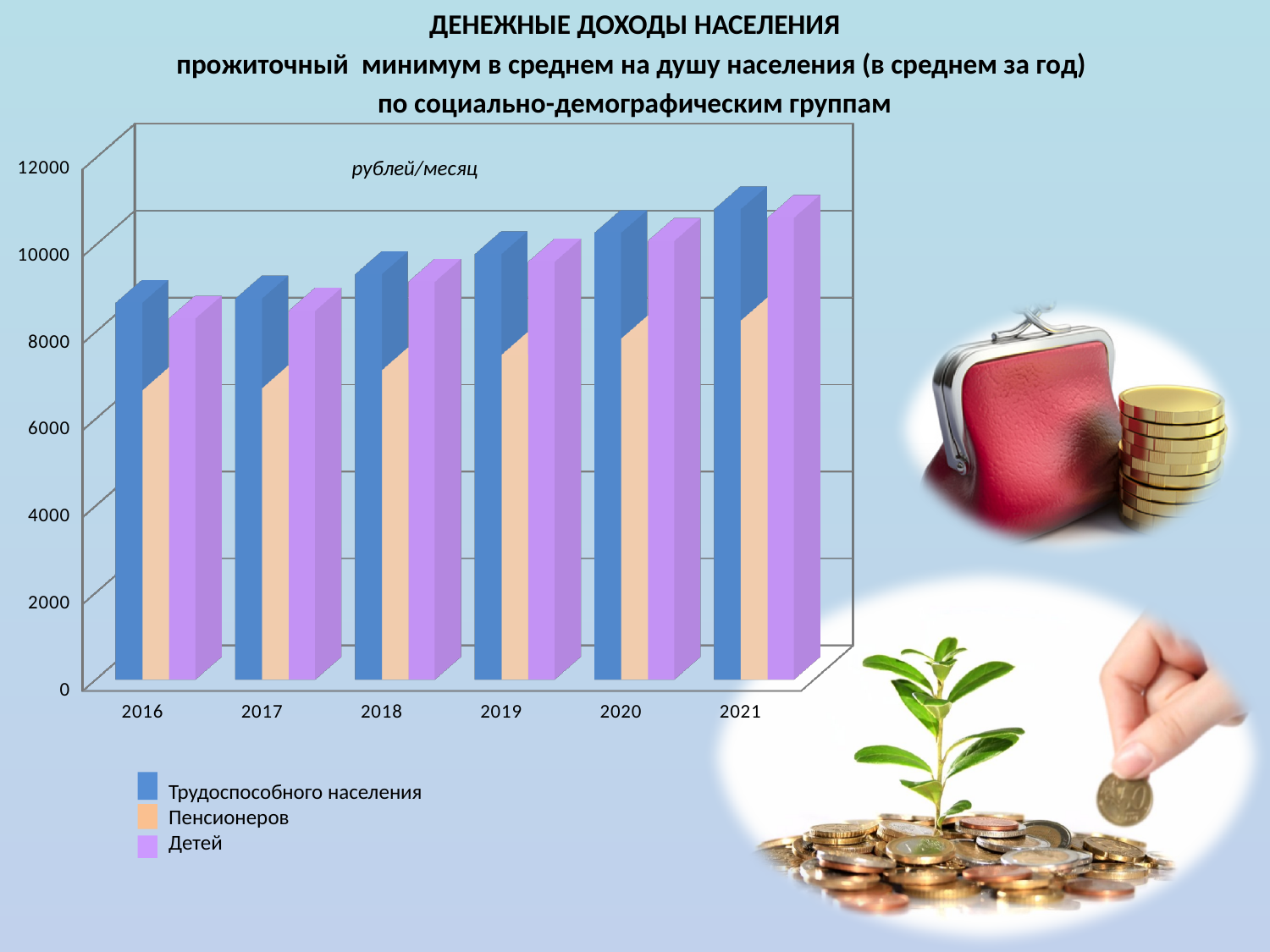
What unit is written inside the chart area? рублей/месяц Is the value for Трудоспособного населения in 2016 greater or less than 8000? greater Is the value for Детей in 2021 greater or less than 10000? greater Which series has the lowest values in every year? Пенсионеров Do the values for Детей rise or fall from 2016 to 2021? rise In which year is the value for Пенсионеров lowest? 2016 Is the value for Пенсионеров in 2016 greater or less than 8000? less What kind of chart is shown on the slide? bar chart How many series does the legend list? 3 In 2021, which is larger: the value for Трудоспособного населения or for Пенсионеров? Трудоспособного населения How many years are shown on the x axis of the chart? 6 In which year is the value for Трудоспособного населения highest? 2021